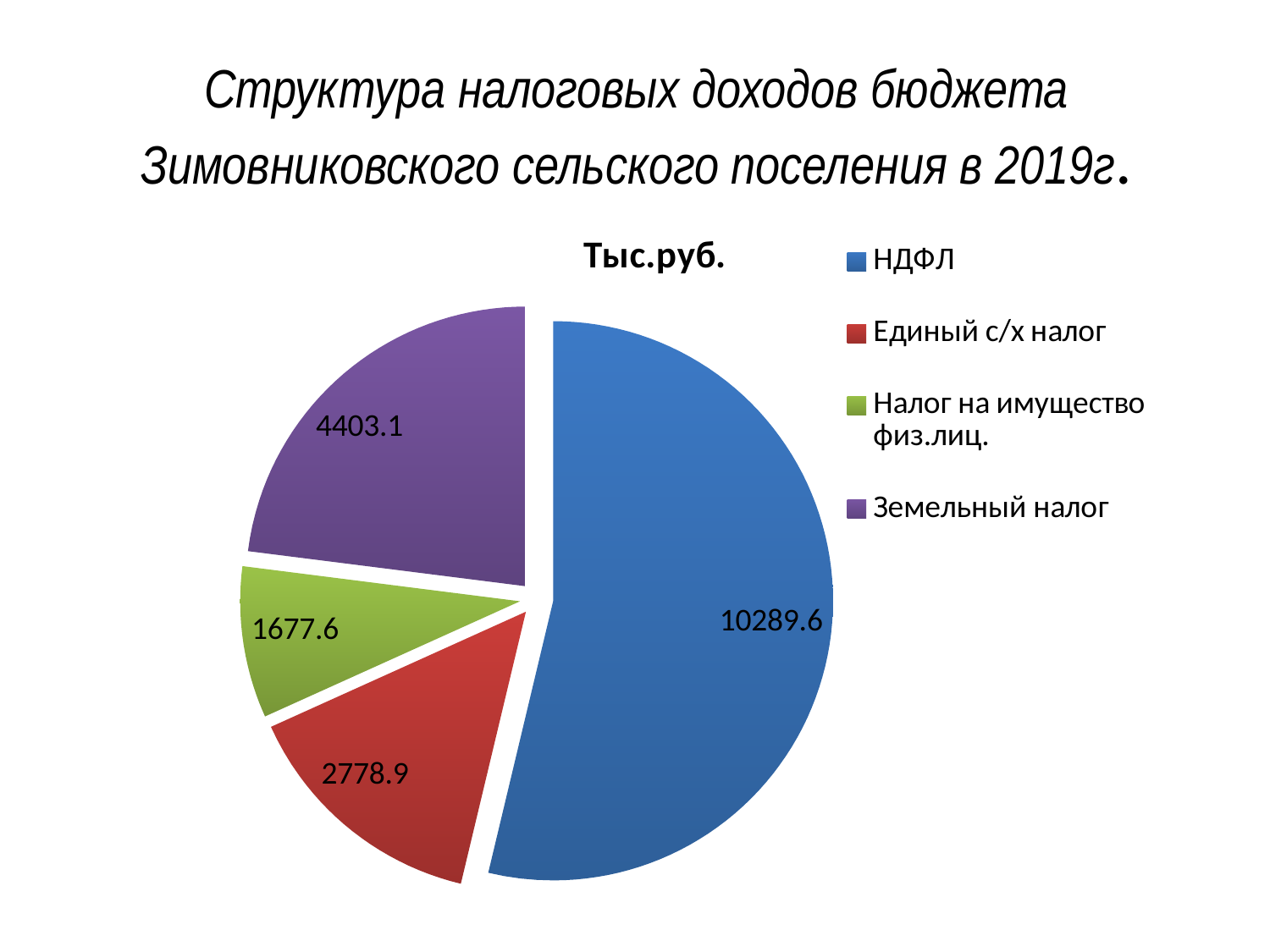
What is the difference between the values for НДФЛ and Земельный налог? 5886.5 What is the title shown above the pie chart? Тыс.руб. What is the value for НДФЛ? 10289.6 What kind of chart is shown on the slide? Pie chart What is the value for Единый с/х налог? 2778.9 How many categories does the pie chart show? 4 What is the value for Налог на имущество физ.лиц.? 1677.6 What is the value for Земельный налог? 4403.1 Which category has the smallest slice? Налог на имущество физ.лиц. Which category has the largest slice? НДФЛ What is the difference between the values for Земельный налог and Единый с/х налог? 1624.2 Which is larger, the value for Единый с/х налог or the value for Налог на имущество физ.лиц.? Единый с/х налог